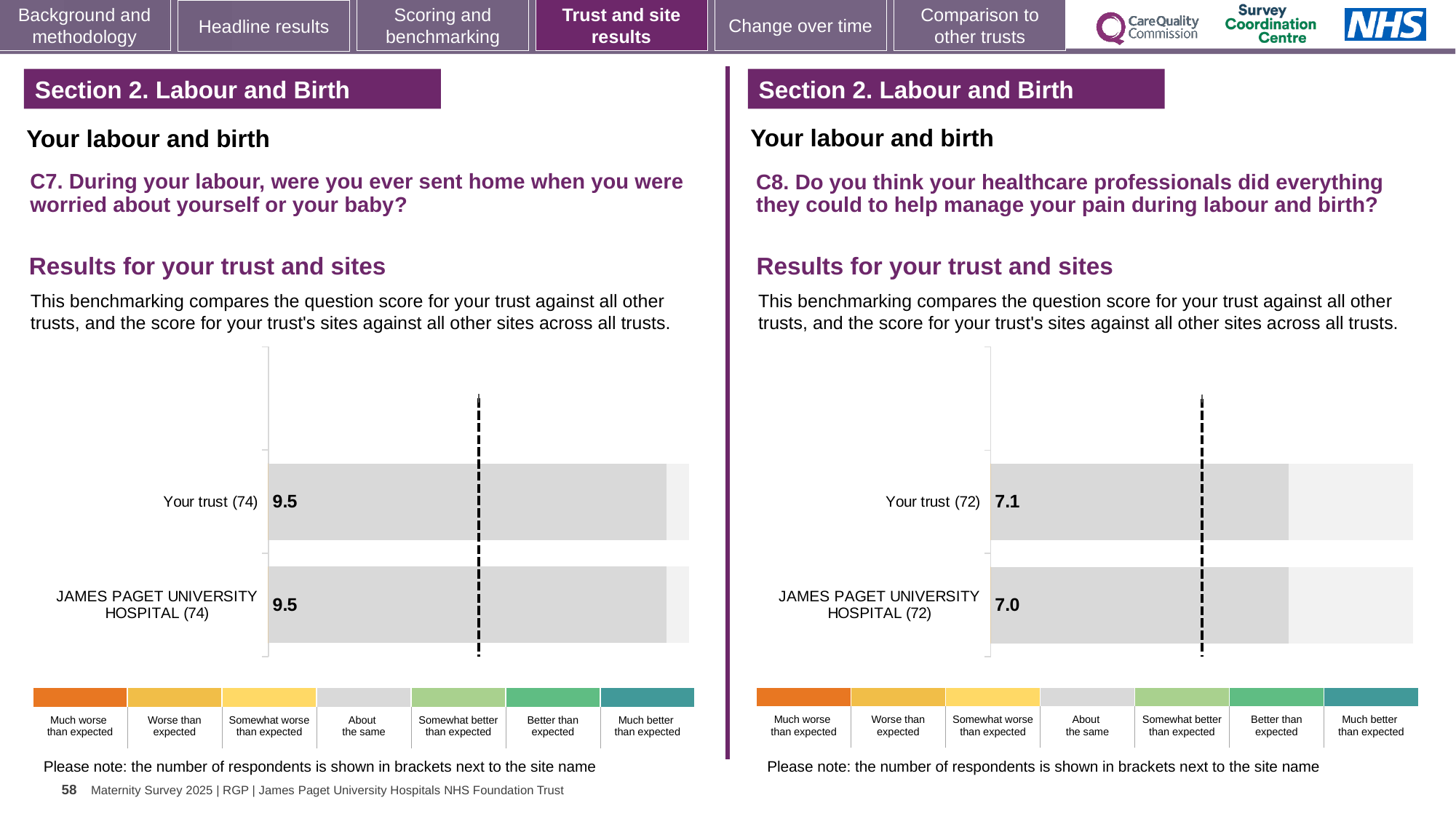
On the C8 chart (right), what is the score for Your trust? 7.1 What type of chart is used on the C7 chart (left)? Bar chart On the C8 chart (right), how many respondents are shown in brackets for James Paget University Hospital? 72 On the C7 chart (left), is the score for Your trust the same as the score for James Paget University Hospital? Yes On the C7 chart (left), how many bars are plotted? 2 On the C7 chart (left), what is the score for James Paget University Hospital? 9.5 On the C8 chart (right), what is the difference between the score for Your trust and the score for James Paget University Hospital? 0.1 On the C8 chart (right), how many bars are plotted? 2 On the C7 chart (left), what is the score for Your trust? 9.5 On the C8 chart (right), what is the score for James Paget University Hospital? 7.0 On the C7 chart (left), how many respondents are shown in brackets for Your trust? 74